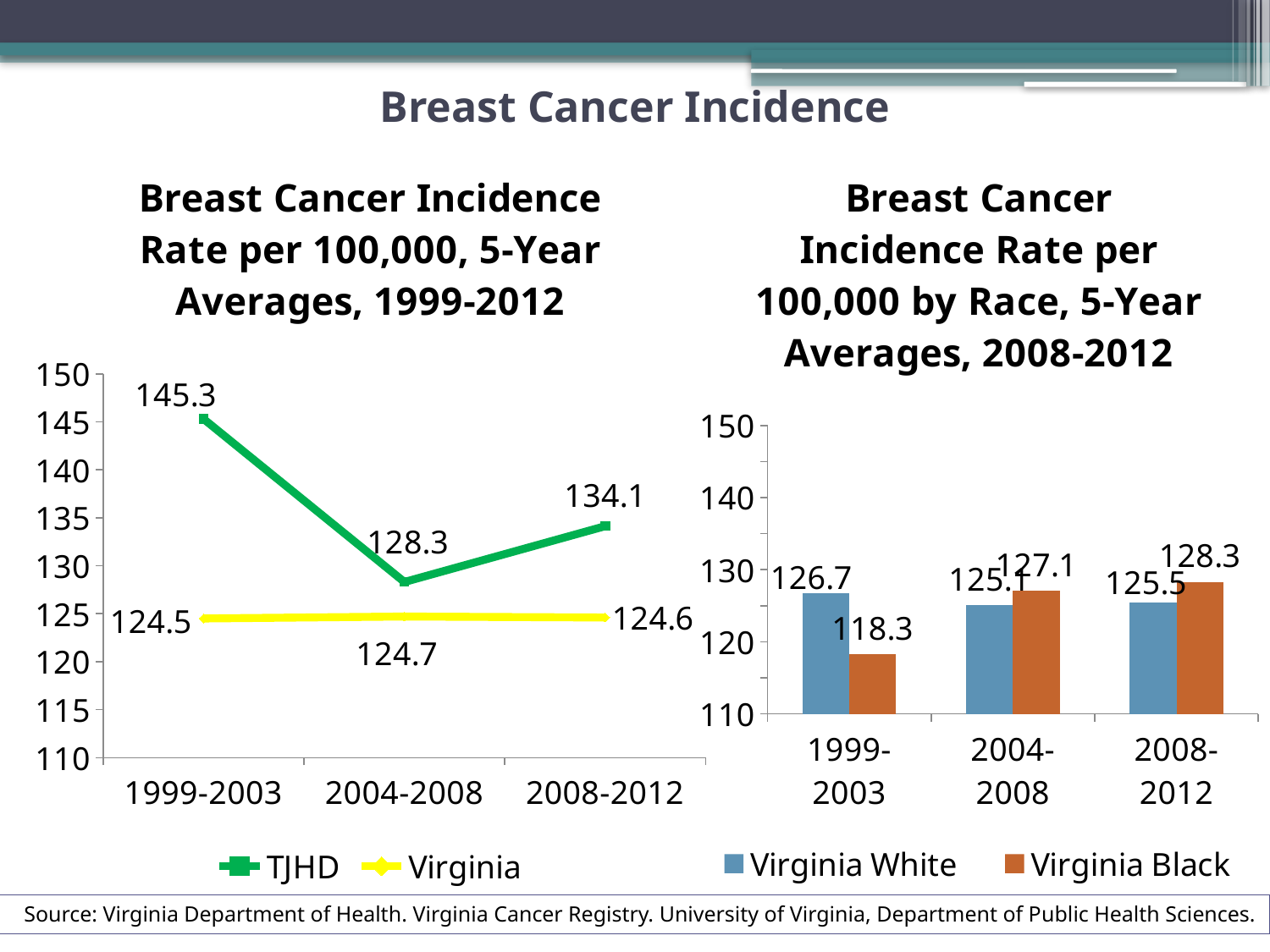
In the left chart, which period has the lowest TJHD value? 2004-2008 How many series does the legend of the left chart list? 2 What kind of chart is the left chart? line chart In the left chart (Breast Cancer Incidence Rate per 100,000, 5-Year Averages, 1999-2012), what is the TJHD value for 1999-2003? 145.3 What kind of chart is the right chart? bar chart In the right chart (Breast Cancer Incidence Rate per 100,000 by Race), what is the Virginia Black value for 1999-2003? 118.3 In the left chart, does the TJHD line rise or fall from 1999-2003 to 2004-2008? fall In the right chart, which is larger for 2008-2012, Virginia White or Virginia Black? Virginia Black In the left chart, what is the difference between the TJHD and Virginia values for 2008-2012? 9.5 In the right chart, what is the difference between the Virginia White and Virginia Black values for 1999-2003? 8.4 In the left chart, what is the Virginia value for 2004-2008? 124.7 In the right chart, what is the Virginia White value for 1999-2003? 126.7